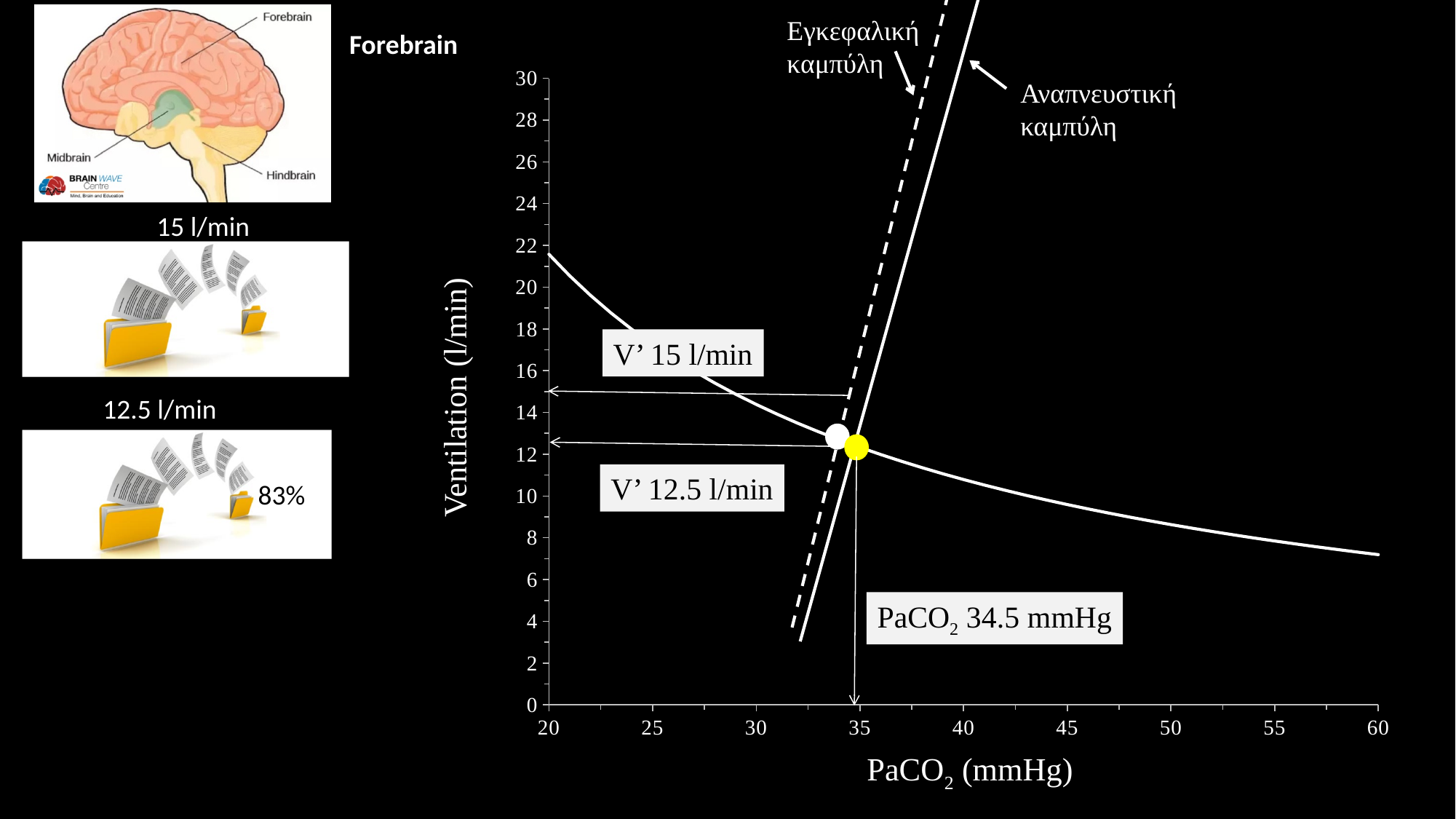
What kind of chart is shown on the slide? line chart Is the ventilation on the curved line at PaCO2 = 60 mmHg greater or less than 10 l/min? less Does the ventilation along the curved line rise or fall as PaCO2 increases from 20 to 60 mmHg? fall What is the highest value shown on the y axis of the chart? 30 What ventilation value is labelled for the yellow point on the chart? 12.5 l/min What PaCO2 value is marked by the vertical arrow at the yellow point on the chart? 34.5 mmHg What is the label of the y axis of the chart? Ventilation (l/min) Which of the two labelled ventilation values on the chart is larger, V' 15 l/min or V' 12.5 l/min? V' 15 l/min Is the ventilation on the curved line at PaCO2 = 20 mmHg greater or less than 20 l/min? greater What is the difference between the two labelled ventilation values, V' 15 l/min and V' 12.5 l/min? 2.5 l/min What ventilation value is labelled for the upper horizontal arrow on the chart? 15 l/min What is the label of the x axis of the chart? PaCO2 (mmHg)